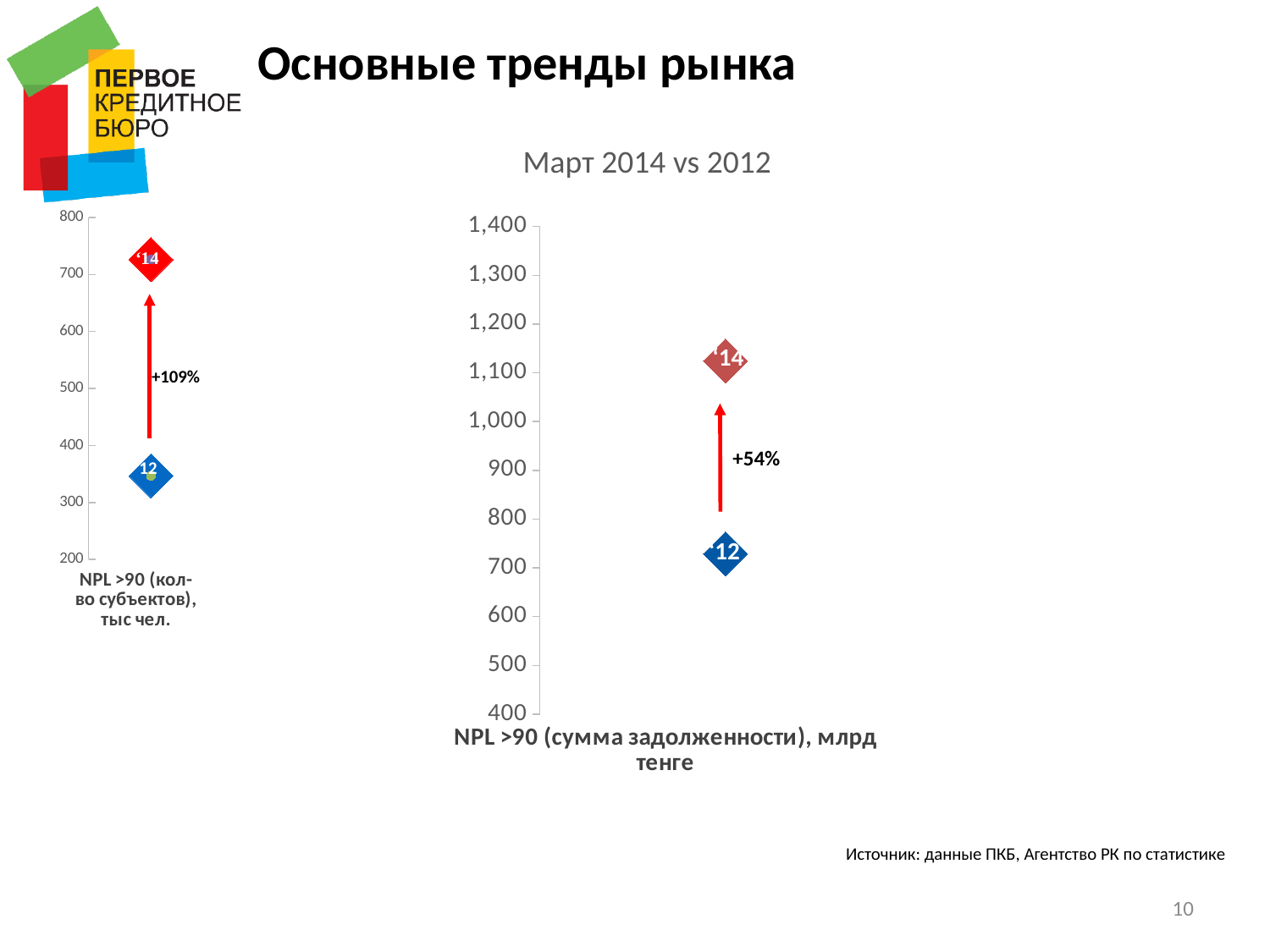
On the left chart (NPL >90, кол-во субъектов), which point is higher, '12 or '14? '14 On the right chart (NPL >90, сумма задолженности), is the value for '12 greater or less than 800? less How many data points are plotted on the right chart (NPL >90, сумма задолженности)? 2 What is the axis label printed under the right chart? NPL >90 (сумма задолженности), млрд тенге On the left chart (NPL >90, кол-во субъектов), is the value for '14 greater or less than 600? greater On the right chart (NPL >90, сумма задолженности), is the value for '14 greater or less than 1,000? greater On the left chart (NPL >90, кол-во субъектов), does the value rise or fall from '12 to '14? rise What period comparison is stated in the subtitle above the charts? Март 2014 vs 2012 On the right chart (NPL >90, сумма задолженности), which point is lower, '12 or '14? '12 On the left chart (NPL >90, кол-во субъектов), what percentage change is printed between the '12 and '14 points? +109% On the right chart (NPL >90, сумма задолженности), what percentage change is printed between the '12 and '14 points? +54%